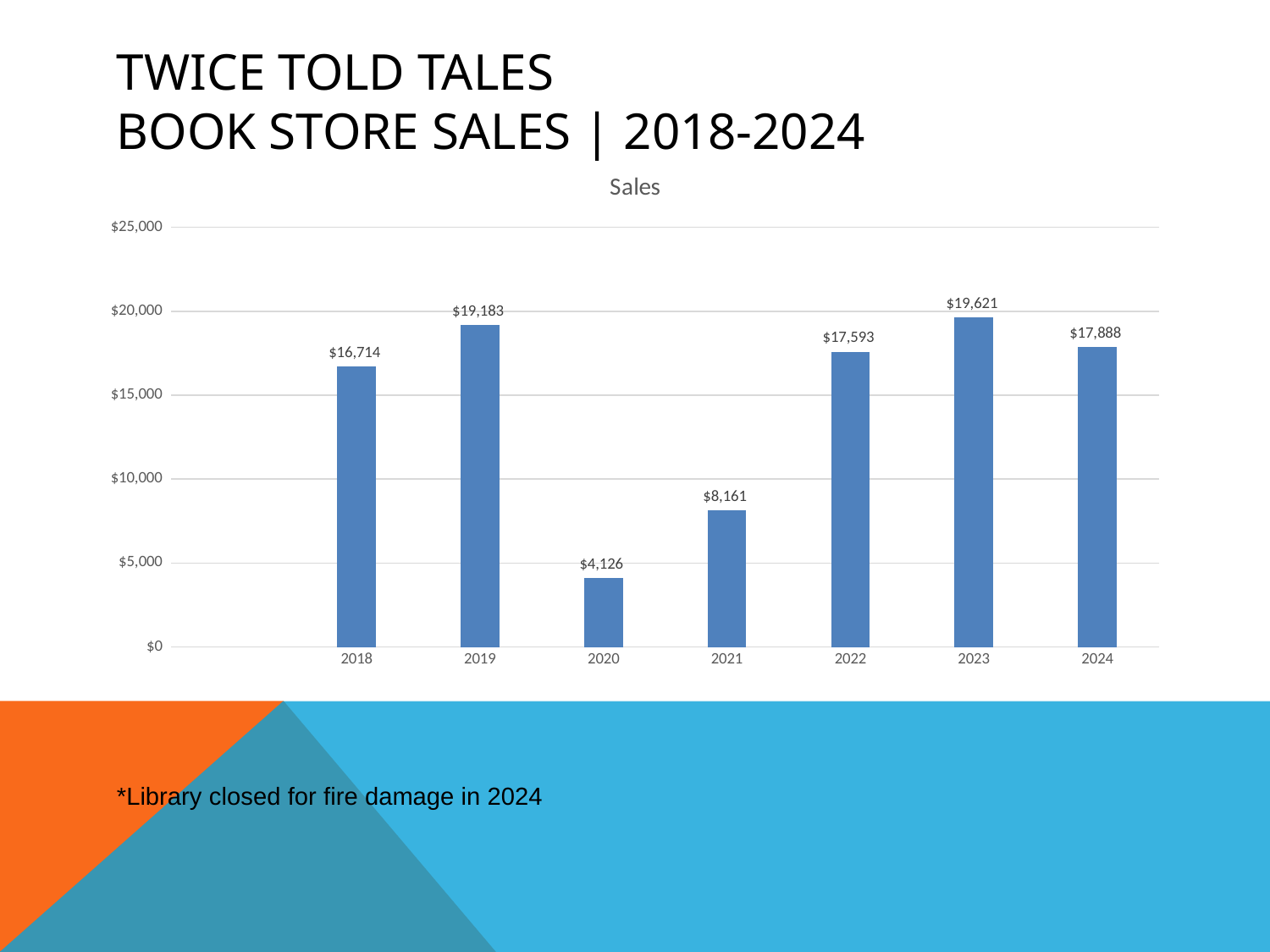
What were the sales in 2024? $17,888 How many years are shown on the x axis? 7 What is the difference in sales between 2023 and 2020? $15,495 What kind of chart is shown on the slide? bar chart Which year had higher sales, 2019 or 2022? 2019 What is the difference in sales between 2021 and 2020? $4,035 What is the title of the chart? Sales Which year had the highest sales? 2023 What were the sales in 2020? $4,126 Which year had the lowest sales? 2020 Is the value for 2021 greater or less than $10,000? less What were the sales in 2018? $16,714